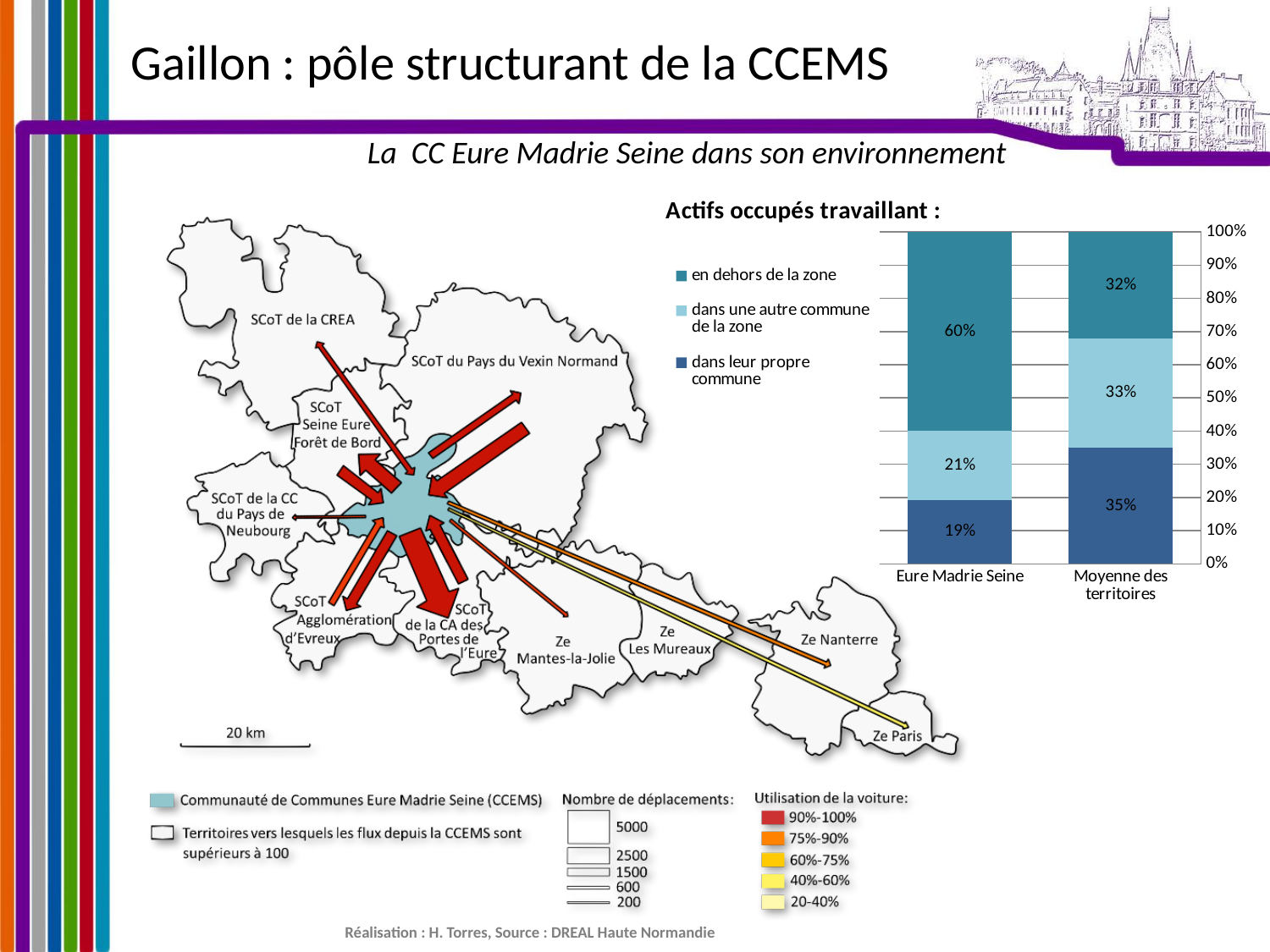
In the chart 'Actifs occupés travaillant :', what is the difference between the 'en dehors de la zone' values for Eure Madrie Seine and Moyenne des territoires? 28% In the chart 'Actifs occupés travaillant :', what is the value for 'dans leur propre commune' for Eure Madrie Seine? 19% In the chart 'Actifs occupés travaillant :', which series has the lowest value for Eure Madrie Seine? dans leur propre commune In the chart 'Actifs occupés travaillant :', what is the value for 'dans une autre commune de la zone' for Moyenne des territoires? 33% In the chart 'Actifs occupés travaillant :', what is the value for 'en dehors de la zone' for Moyenne des territoires? 32% In the chart 'Actifs occupés travaillant :', which series has the highest value for Eure Madrie Seine? en dehors de la zone In the chart 'Actifs occupés travaillant :', what share of Eure Madrie Seine workers work 'en dehors de la zone'? 60% In the chart 'Actifs occupés travaillant :', which is larger for 'dans leur propre commune': Eure Madrie Seine or Moyenne des territoires? Moyenne des territoires How many categories are shown on the x axis of the chart 'Actifs occupés travaillant :'? 2 How many series does the legend of the chart 'Actifs occupés travaillant :' list? 3 What kind of chart is 'Actifs occupés travaillant :'? stacked bar chart In the chart 'Actifs occupés travaillant :', what is the value for 'dans leur propre commune' for Moyenne des territoires? 35%